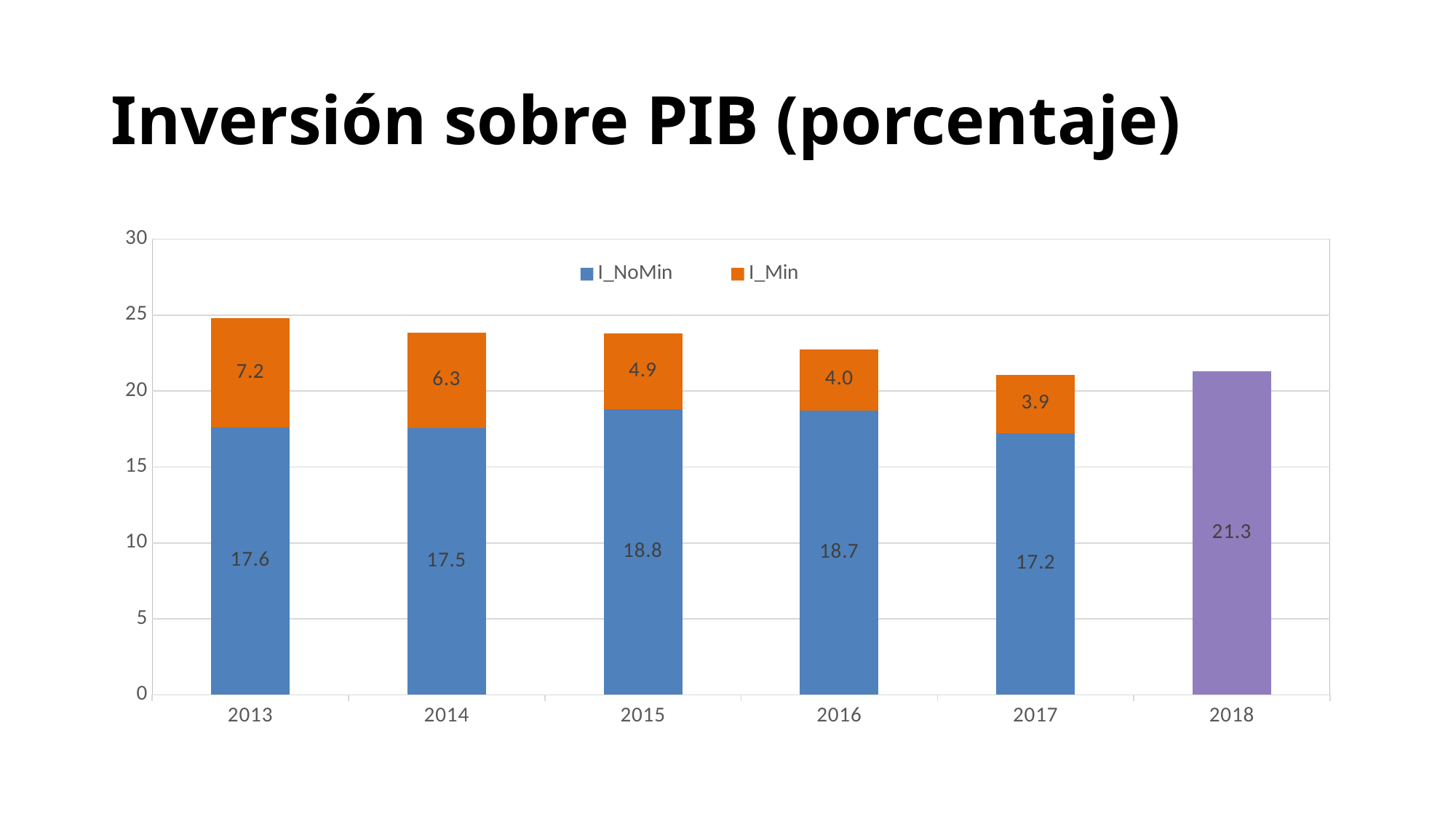
What is the I_NoMin value for 2015? 18.8 In which year is the I_Min value lowest? 2017 Does the I_Min value rise or fall from 2013 to 2017? fall How many series does the legend list? 2 What type of chart is shown on the slide? stacked bar chart What is the difference between the I_Min values for 2013 and 2017? 3.3 In which year is the I_Min value highest? 2013 What value is labelled on the 2018 bar? 21.3 What is the I_Min value for 2014? 6.3 How many years are shown on the x axis? 6 Which is larger, the I_NoMin value for 2013 or for 2017? 2013 What is the total of the stacked bar for 2013? 24.8